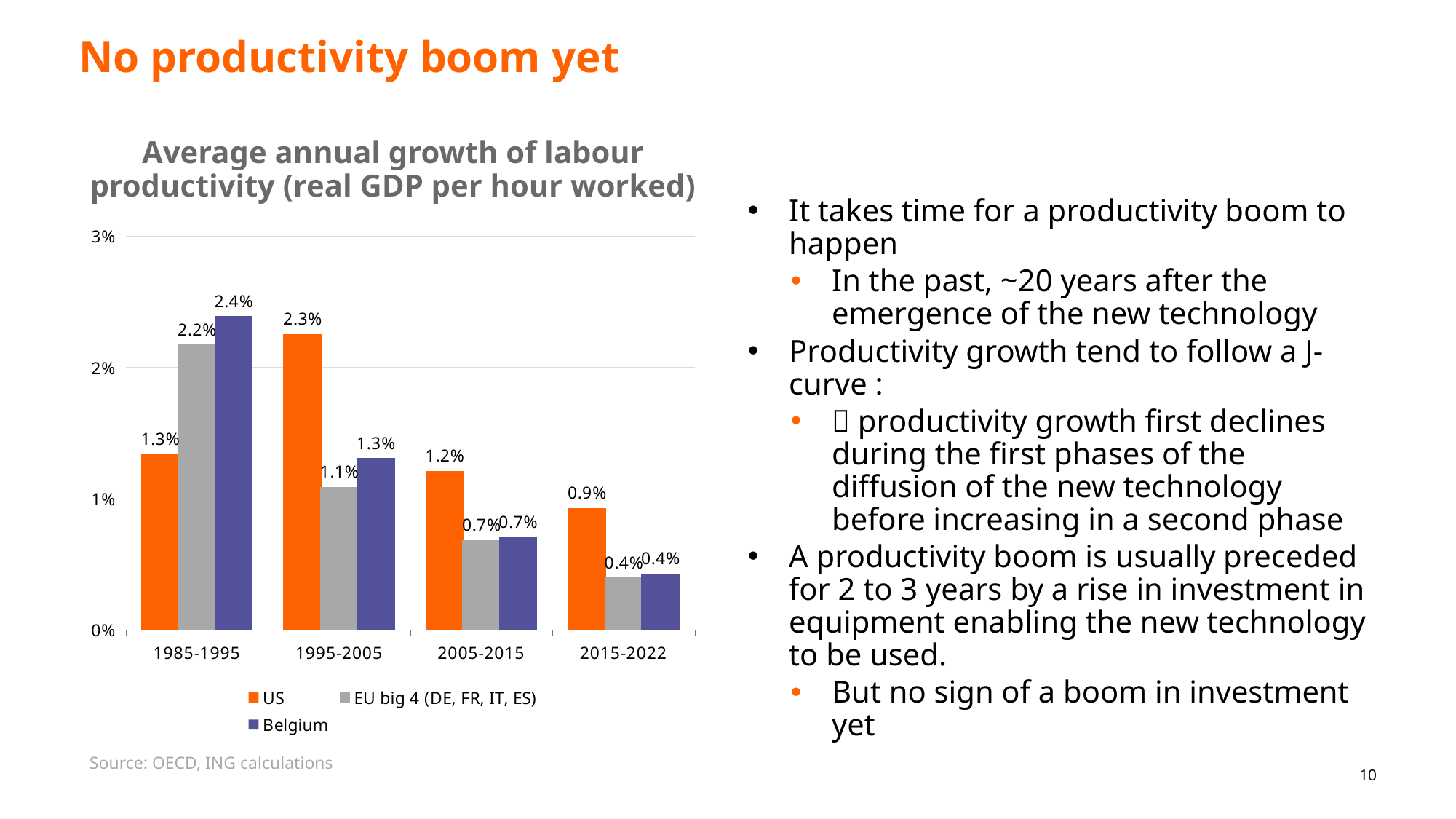
How many periods are shown on the x axis? 4 In which period is the US value highest? 1995-2005 In which period is the Belgium value lowest? 2015-2022 Which is larger in 1985-1995, the US value or the Belgium value? Belgium Is the US value for 2015-2022 greater or less than 1%? less What is the difference between the US value and the EU big 4 value in 1995-2005? 1.2% What kind of chart is shown on the slide? bar chart What is the value for the US in 1995-2005? 2.3% What is the value for Belgium in 1985-1995? 2.4% How many series does the legend list? 3 What is the value for EU big 4 (DE, FR, IT, ES) in 2015-2022? 0.4% Do the US values rise or fall from 1995-2005 to 2015-2022? fall